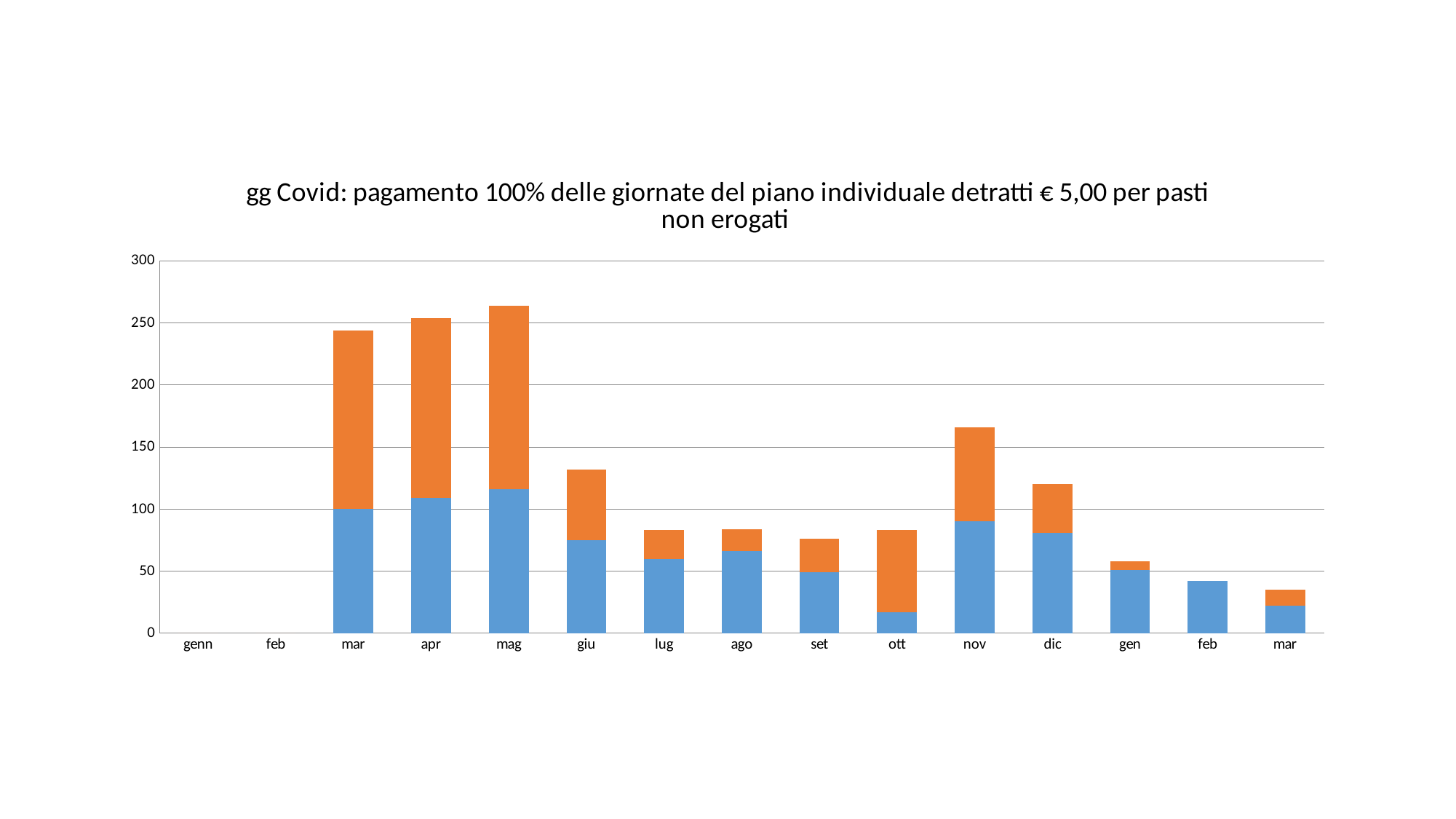
Is the total for giu greater or less than 150? less Is the total for the first mar bar greater or less than 200? greater Is the total for nov greater or less than 150? greater What kind of chart is shown on the slide? Stacked bar chart Which has the larger total bar, giu or lug? giu How many month categories show no bar at all? 2 Which month has the highest total bar? mag Which has the larger total bar, nov or dic? nov How many month categories are shown on the x axis? 15 Do the total bar heights rise or fall from mag to set? fall